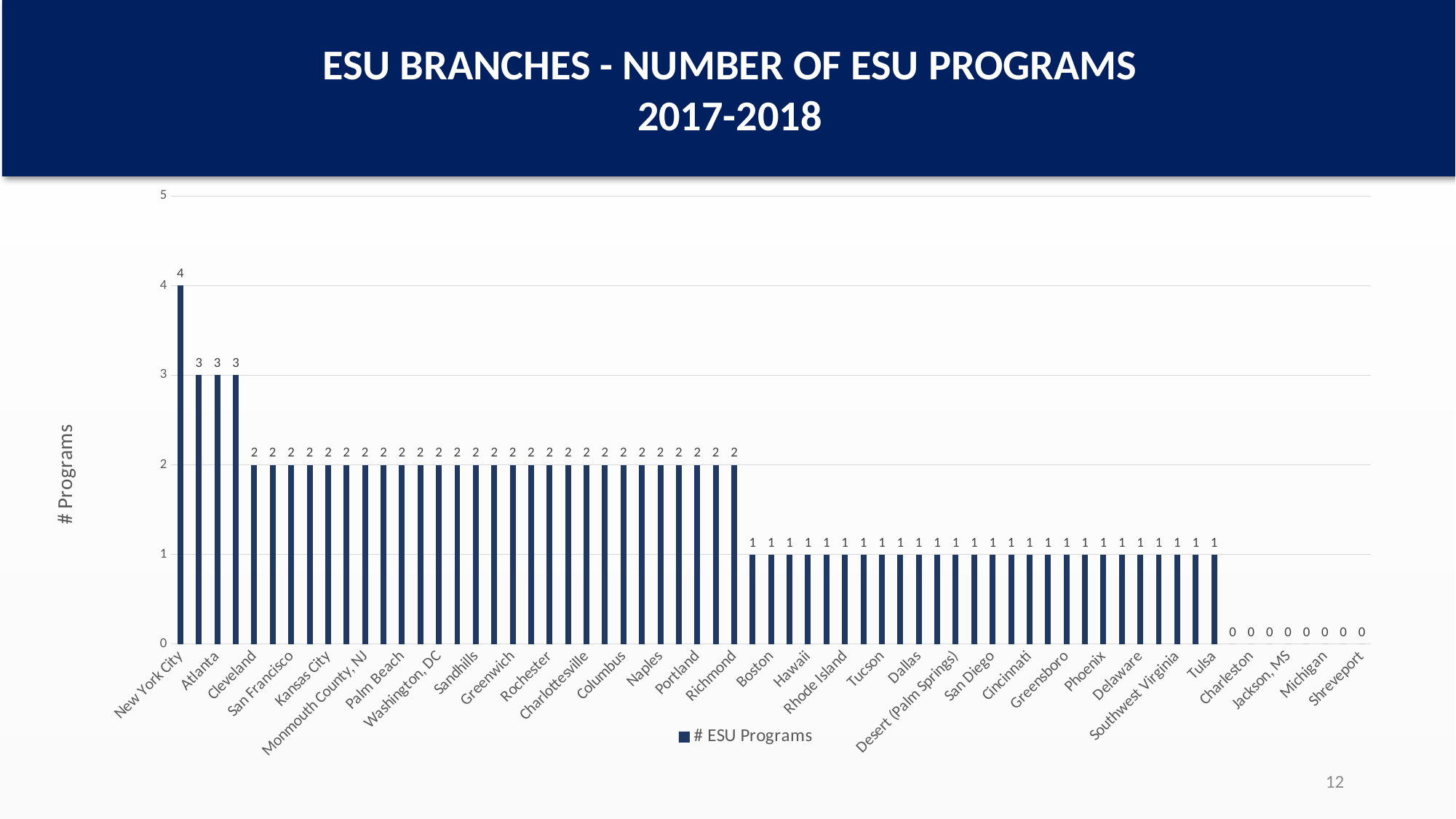
How many branches have 0 ESU programs? 8 What is the difference in number of ESU programs between New York City and Atlanta? 1 How many ESU programs does Atlanta have? 3 How many ESU programs does New York City have? 4 What is the lowest number of ESU programs shown for any branch? 0 Which has more ESU programs, New York City or Tulsa? New York City Do the values generally rise or fall moving from left to right along the x axis? fall How many ESU programs does Shreveport have? 0 How many series does the legend list? 1 How many ESU programs does Boston have? 1 What type of chart is shown on the slide? bar chart Which branch has the highest number of ESU programs? New York City